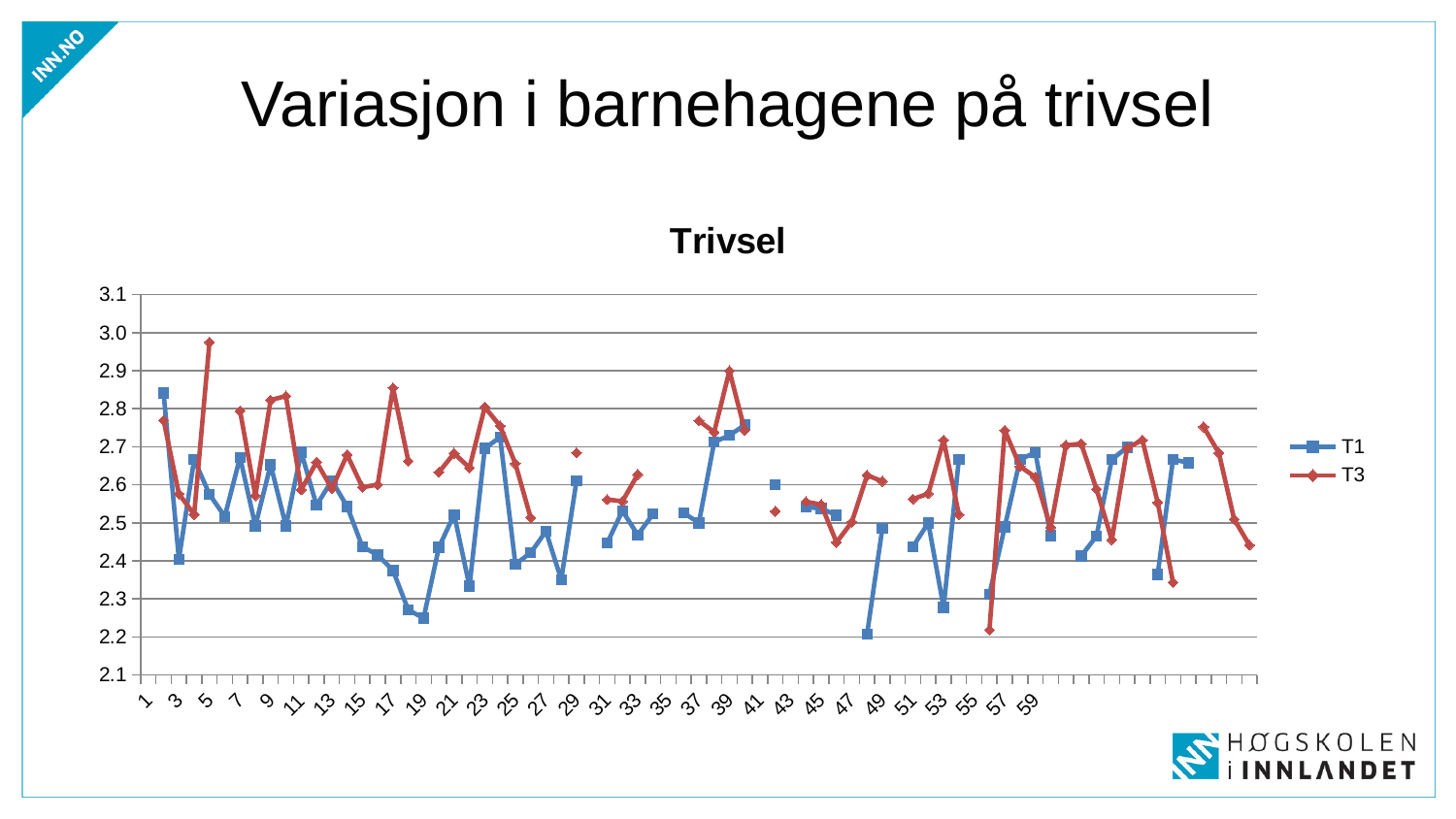
Which series reaches the highest value anywhere on the chart? T3 Is the value of T3 at x = 5 greater or less than 2.9? greater How many series does the legend list? 2 Is the value of T1 at x = 49 greater or less than 2.3? greater At x = 5, which series has the larger value, T1 or T3? T3 Is the value of T1 at x = 3 greater or less than 2.5? less What kind of chart is shown on the slide? line chart What is the title of the chart? Trivsel Which series is drawn in red? T3